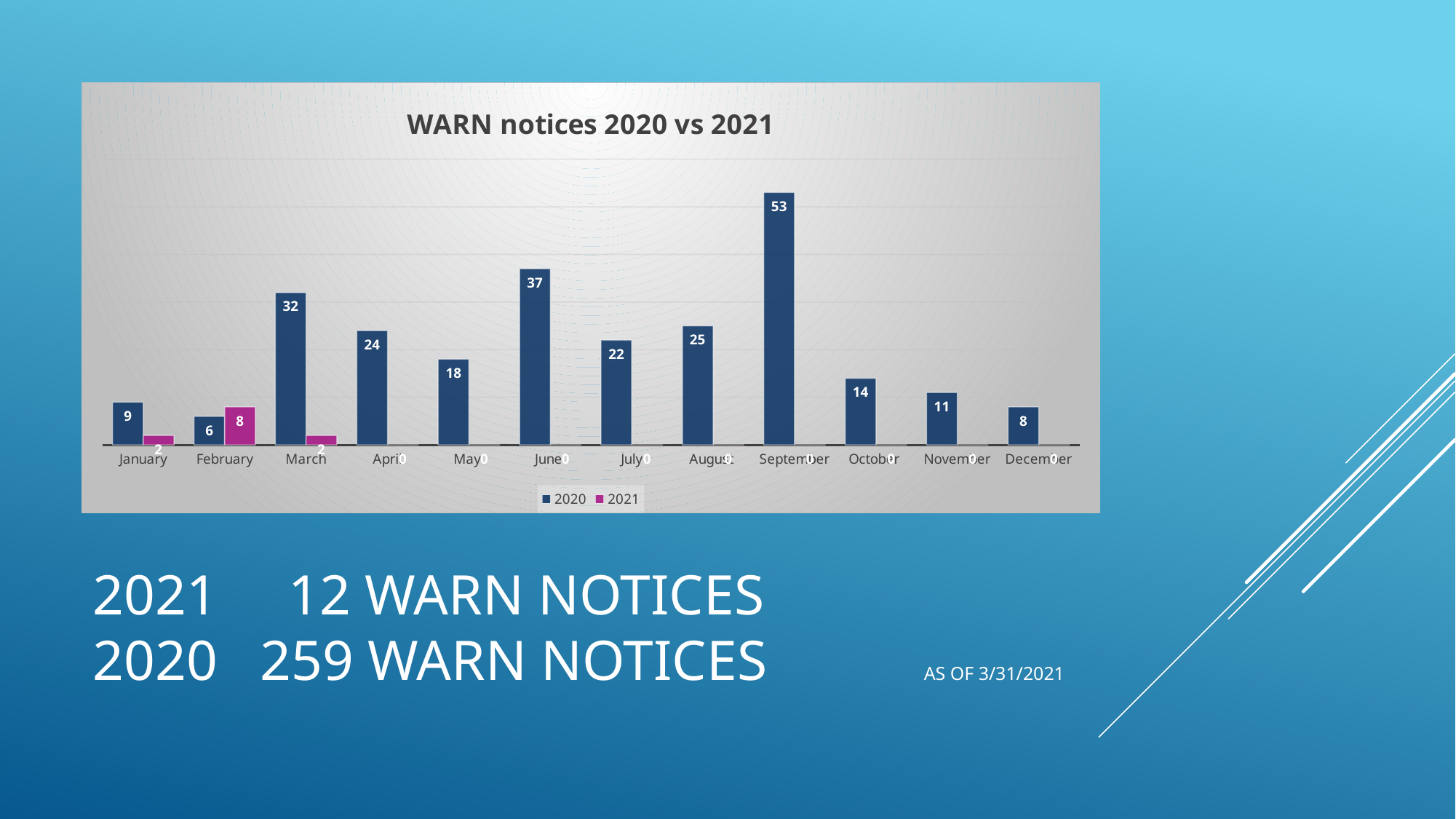
Which is larger, the 2020 value for April or the 2020 value for August? August What is the 2020 value for March? 32 How many months are shown on the x axis? 12 Which month has the highest 2020 value? September What is the title of the chart? WARN notices 2020 vs 2021 In February, which series has the larger value, 2020 or 2021? 2021 What is the 2021 value for February? 8 Which month has the lowest 2020 value? February What is the difference between the 2020 values for June and May? 19 How many series does the legend list? 2 What is the 2020 value for September? 53 What type of chart is shown on the slide? bar chart